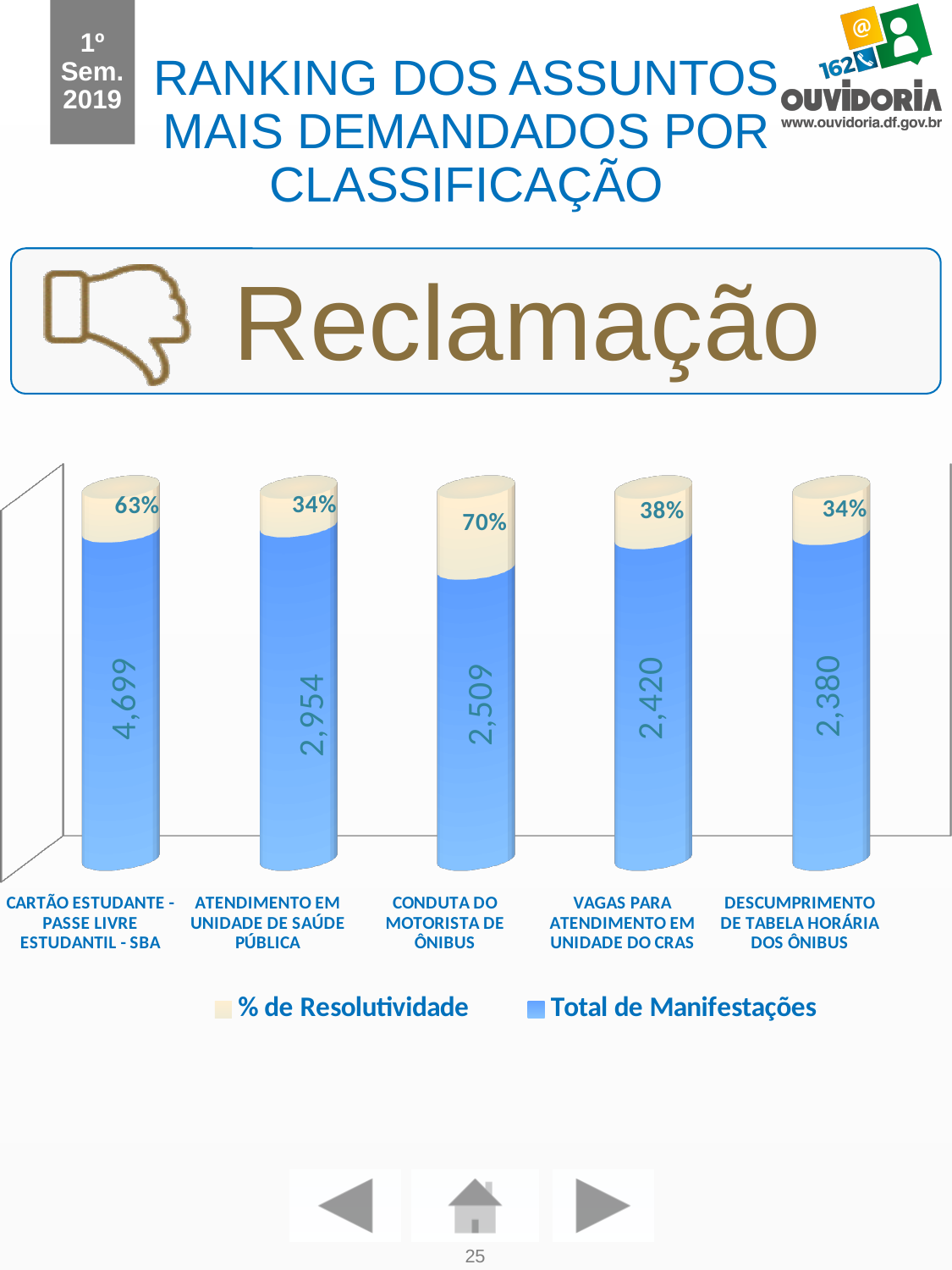
What is the Total de Manifestações for CARTÃO ESTUDANTE - PASSE LIVRE ESTUDANTIL - SBA? 4,699 Which category has the highest Total de Manifestações? CARTÃO ESTUDANTE - PASSE LIVRE ESTUDANTIL - SBA What is the difference in Total de Manifestações between CARTÃO ESTUDANTE - PASSE LIVRE ESTUDANTIL - SBA and ATENDIMENTO EM UNIDADE DE SAÚDE PÚBLICA? 1,745 How many categories are shown in the chart? 5 How many series does the legend list? 2 What is the % de Resolutividade for CONDUTA DO MOTORISTA DE ÔNIBUS? 70% Which category has the highest % de Resolutividade? CONDUTA DO MOTORISTA DE ÔNIBUS Which has a higher % de Resolutividade: CARTÃO ESTUDANTE - PASSE LIVRE ESTUDANTIL - SBA or VAGAS PARA ATENDIMENTO EM UNIDADE DO CRAS? CARTÃO ESTUDANTE - PASSE LIVRE ESTUDANTIL - SBA What kind of chart is shown on the slide? Bar chart What is the % de Resolutividade for DESCUMPRIMENTO DE TABELA HORÁRIA DOS ÔNIBUS? 34% Which category has the lowest Total de Manifestações? DESCUMPRIMENTO DE TABELA HORÁRIA DOS ÔNIBUS What is the Total de Manifestações for VAGAS PARA ATENDIMENTO EM UNIDADE DO CRAS? 2,420